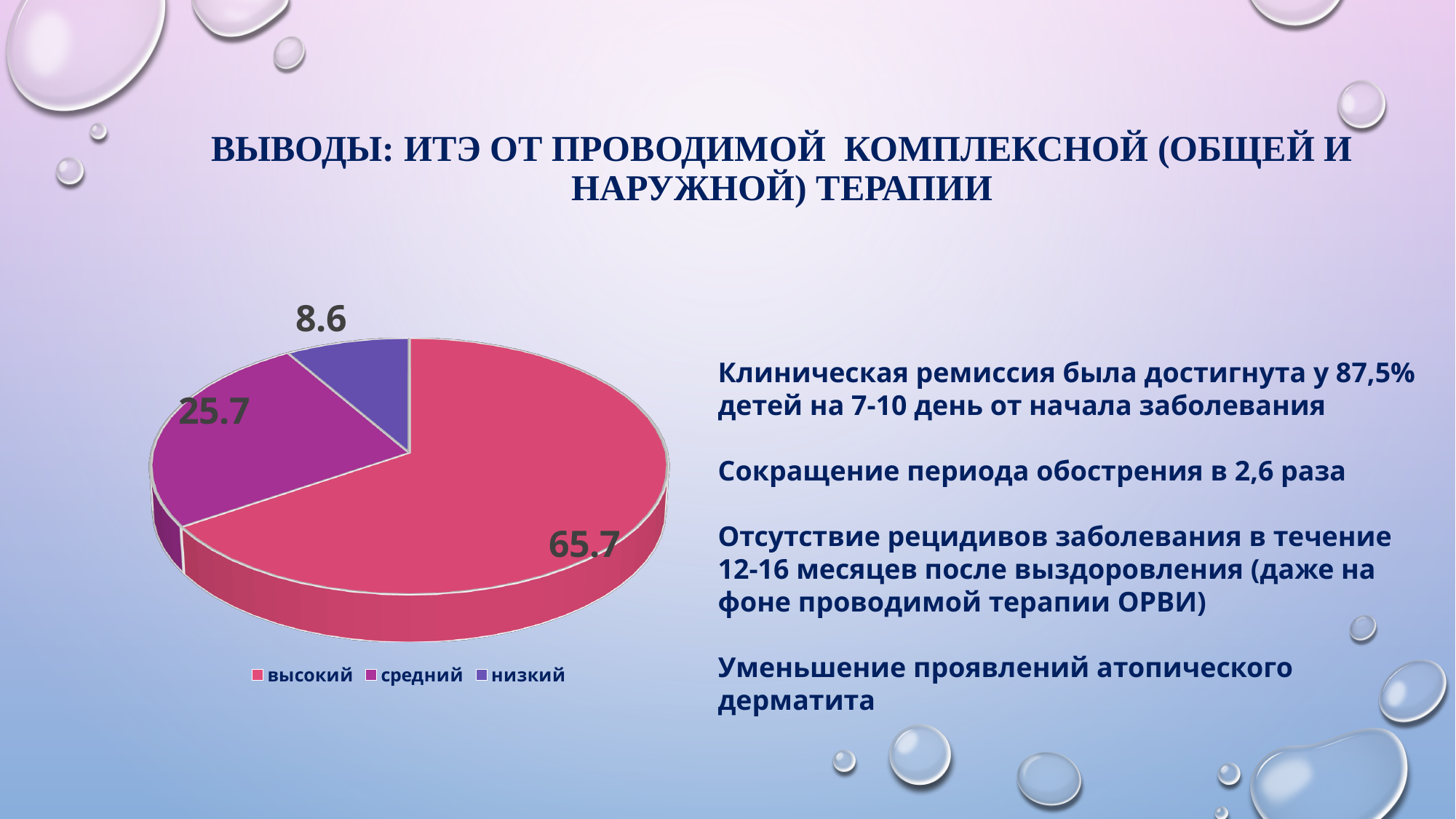
Which is larger in the pie chart, "средний" or "низкий"? средний What colour is the "низкий" slice in the pie chart? purple What is the difference between the "средний" and "низкий" values in the pie chart? 17.1 What kind of chart is shown on the slide? pie chart What is the value for the "низкий" slice of the pie chart? 8.6 How many slices does the pie chart have? 3 Which category has the largest slice in the pie chart? высокий What is the difference between the "высокий" and "средний" values in the pie chart? 40 What is the value for the "высокий" slice of the pie chart? 65.7 Which category has the smallest slice in the pie chart? низкий How many entries does the legend of the pie chart list? 3 What is the value for the "средний" slice of the pie chart? 25.7